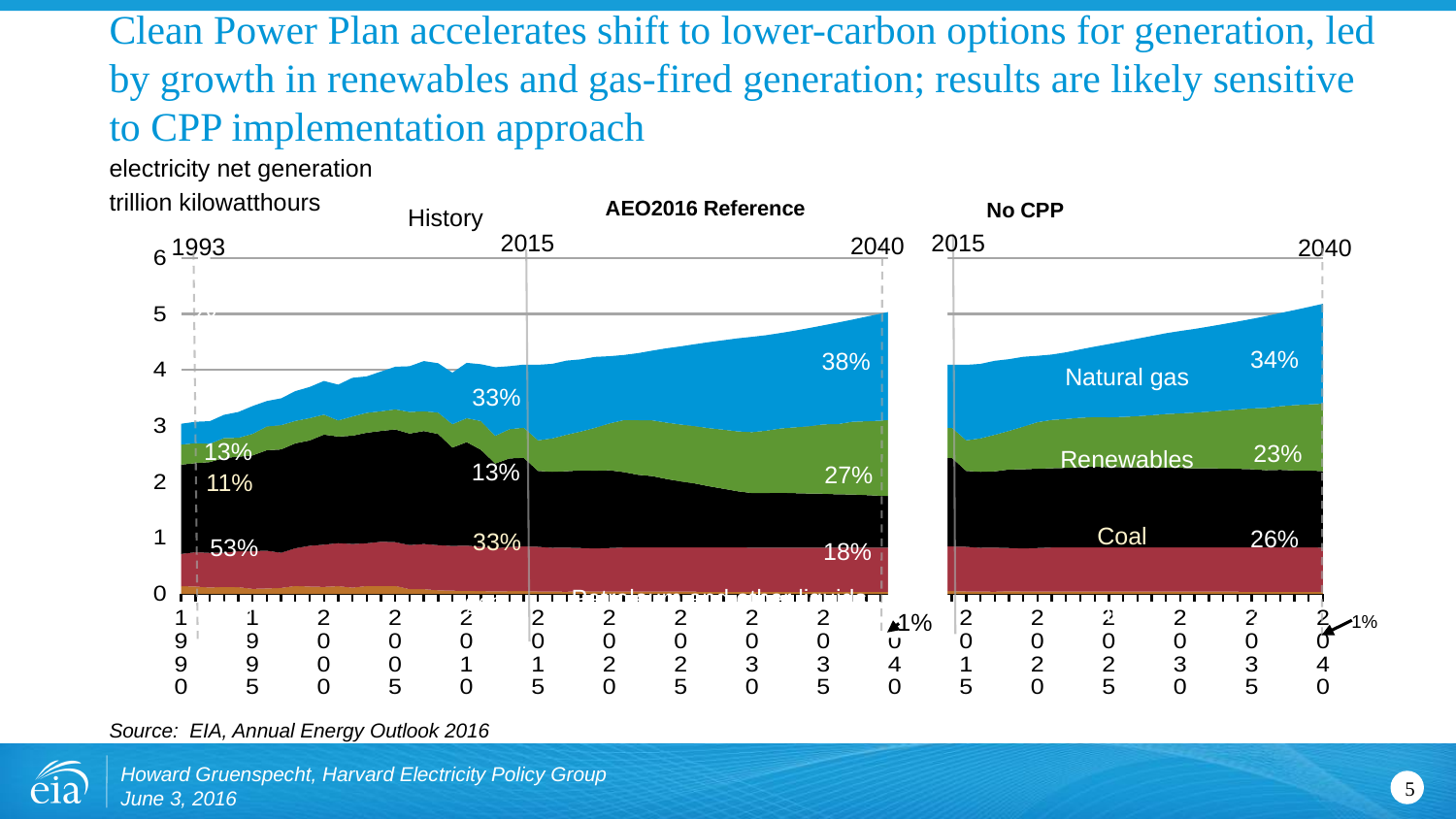
What kind of chart is used on this slide? Stacked area chart In the No CPP chart, what is the coal share in 2040? 26% In the left chart, what share of generation did natural gas have in 2015? 33% In the AEO2016 Reference chart, what is the coal share in 2040? 18% In the No CPP chart, what is the renewables share in 2040? 23% In the AEO2016 Reference chart, what share of electricity net generation does natural gas have in 2040? 38% In the AEO2016 Reference chart, does total electricity net generation rise or fall from 2015 to 2040? Rise In the left chart, what share of generation did coal have in 1993? 53% In the AEO2016 Reference chart, what is the renewables share in 2040? 27% In the No CPP chart, what share of electricity net generation does natural gas have in 2040? 34% How many percentage points higher is the 2040 natural gas share in the AEO2016 Reference chart than in the No CPP chart? 4 percentage points Which chart shows a larger coal share in 2040, AEO2016 Reference or No CPP? No CPP